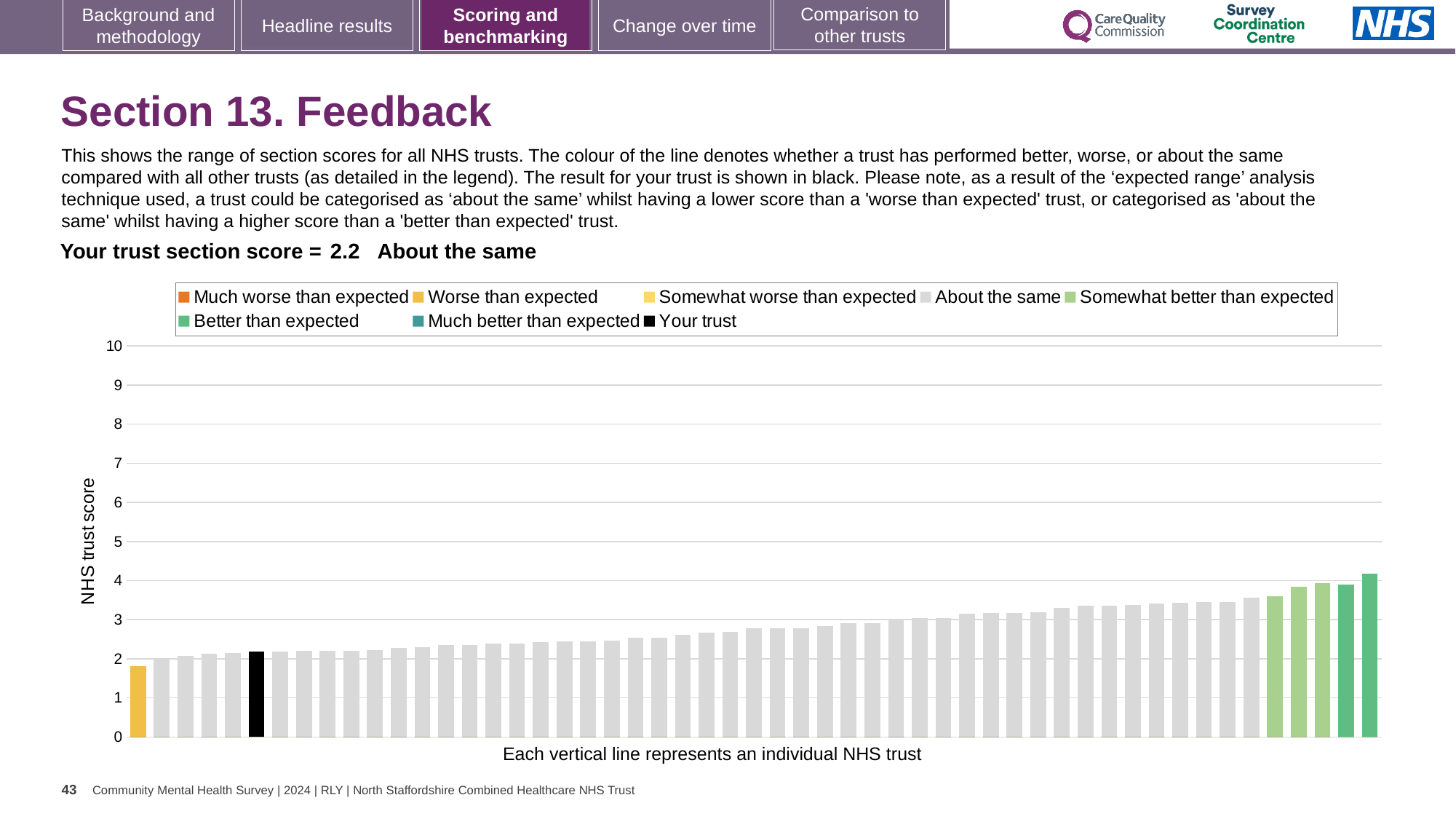
Which category is your trust placed in for this section? About the same What colour is the bar representing your trust? black How many entries does the chart legend list? 8 Is the value of the tallest bar greater or less than 5? less What is the highest value shown on the vertical axis? 10 Is the value of the lowest (yellow) bar greater or less than 2? less Do the bar values rise or fall from left to right across the chart? rise What is the label on the vertical axis of the chart? NHS trust score Is the value of the black bar (your trust) greater or less than 3? less What is the section score for your trust shown on the slide? 2.2 What kind of chart is shown on the slide? bar chart Is the black bar (your trust) higher or lower than the rightmost bar? lower